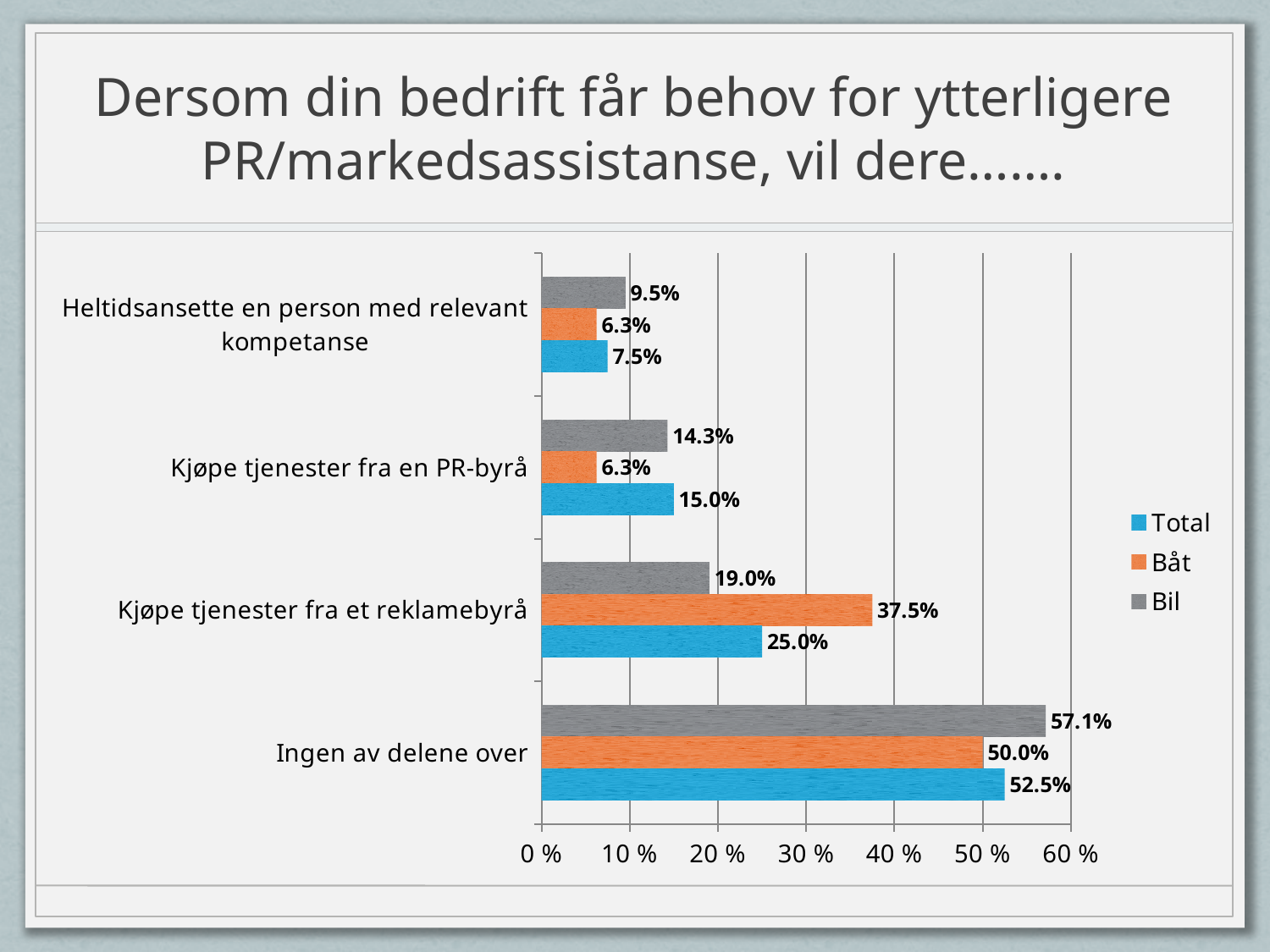
Which category has the lowest Total value? Heltidsansette en person med relevant kompetanse What kind of chart is shown on the slide? Bar chart What is the difference between the Båt and Bil values for "Kjøpe tjenester fra et reklamebyrå"? 18.5% Which category has the highest Bil value? Ingen av delene over For "Ingen av delene over", which is larger: the Bil value or the Båt value? Bil How many categories are shown on the chart? 4 What is the Bil value for "Heltidsansette en person med relevant kompetanse"? 9.5% How many series does the legend list? 3 What is the Total value for "Ingen av delene over"? 52.5% Which colour represents the Båt series in the legend? Orange What is the Total value for "Kjøpe tjenester fra en PR-byrå"? 15.0% What is the Båt value for "Kjøpe tjenester fra et reklamebyrå"? 37.5%